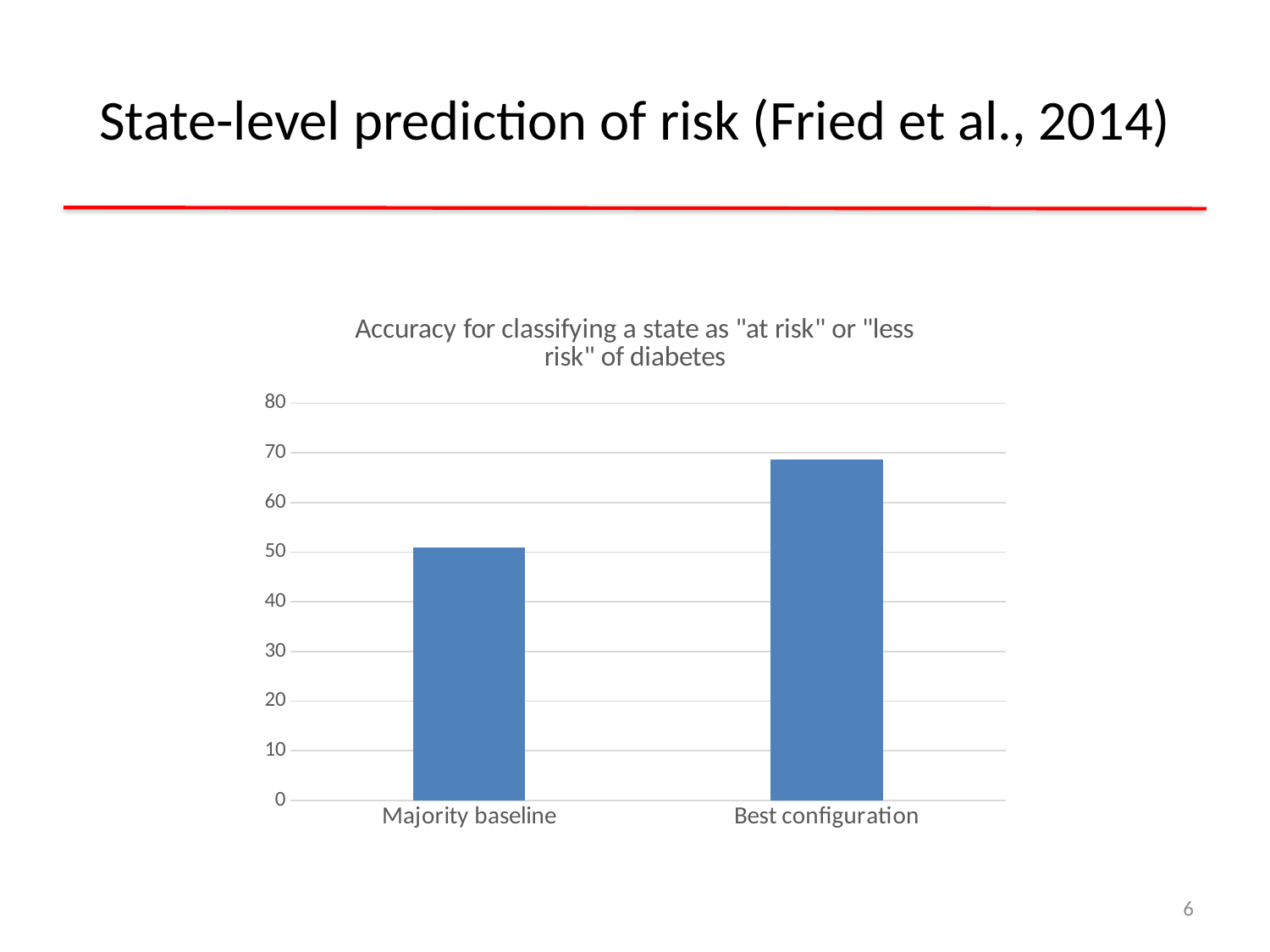
Which is larger, the value for Majority baseline or the value for Best configuration? Best configuration What is the title of the chart? Accuracy for classifying a state as "at risk" or "less risk" of diabetes What is the highest value shown on the vertical axis? 80 Is the value for Majority baseline greater or less than 40? greater Which category has the lowest accuracy? Majority baseline Is the value for Best configuration greater or less than 60? greater Which category has the highest accuracy? Best configuration Is the value for Majority baseline greater or less than 60? less How many categories are plotted in the chart? 2 What kind of chart is shown on the slide? bar chart